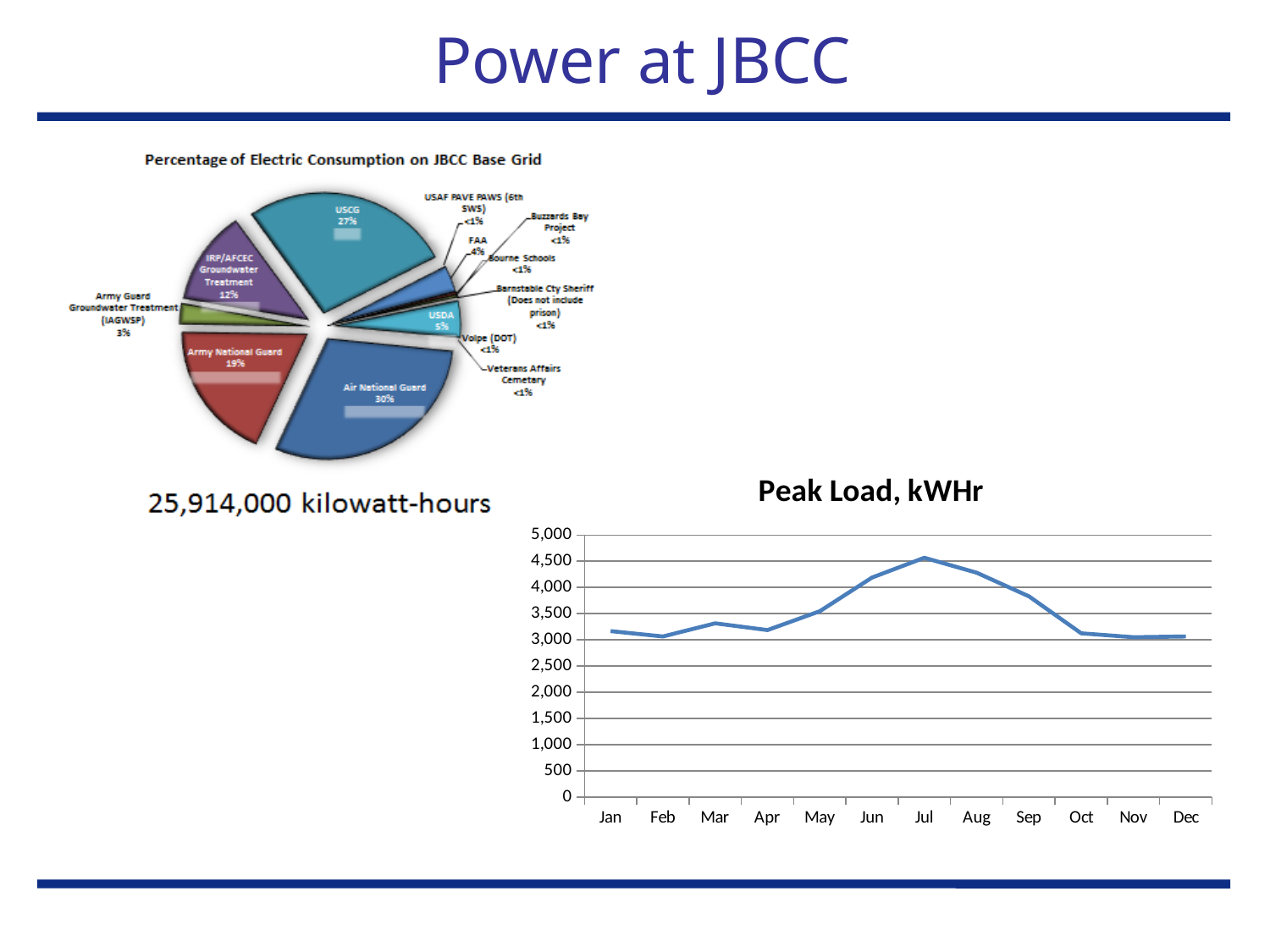
In the 'Peak Load, kWHr' chart, how many months are plotted on the x axis? 12 In the 'Peak Load, kWHr' chart, is the value for Feb greater or less than 3,500? less In the 'Peak Load, kWHr' chart, is the value for Jul greater or less than 4,000? greater In the pie chart 'Percentage of Electric Consumption on JBCC Base Grid', what is the difference in percentage points between Air National Guard and Army National Guard? 11 In the pie chart 'Percentage of Electric Consumption on JBCC Base Grid', what share does USCG have? 27% In the pie chart 'Percentage of Electric Consumption on JBCC Base Grid', which category has the largest share? Air National Guard What kind of chart is 'Peak Load, kWHr'? Line chart In the pie chart 'Percentage of Electric Consumption on JBCC Base Grid', which is larger, USDA or FAA? USDA In the pie chart 'Percentage of Electric Consumption on JBCC Base Grid', what share does Army Guard Groundwater Treatment (IAGWSP) have? 3% In the pie chart 'Percentage of Electric Consumption on JBCC Base Grid', what share does IRP/AFCEC Groundwater Treatment have? 12% In the 'Peak Load, kWHr' chart, which month has the highest peak load? Jul In the pie chart 'Percentage of Electric Consumption on JBCC Base Grid', what share does Air National Guard have? 30%